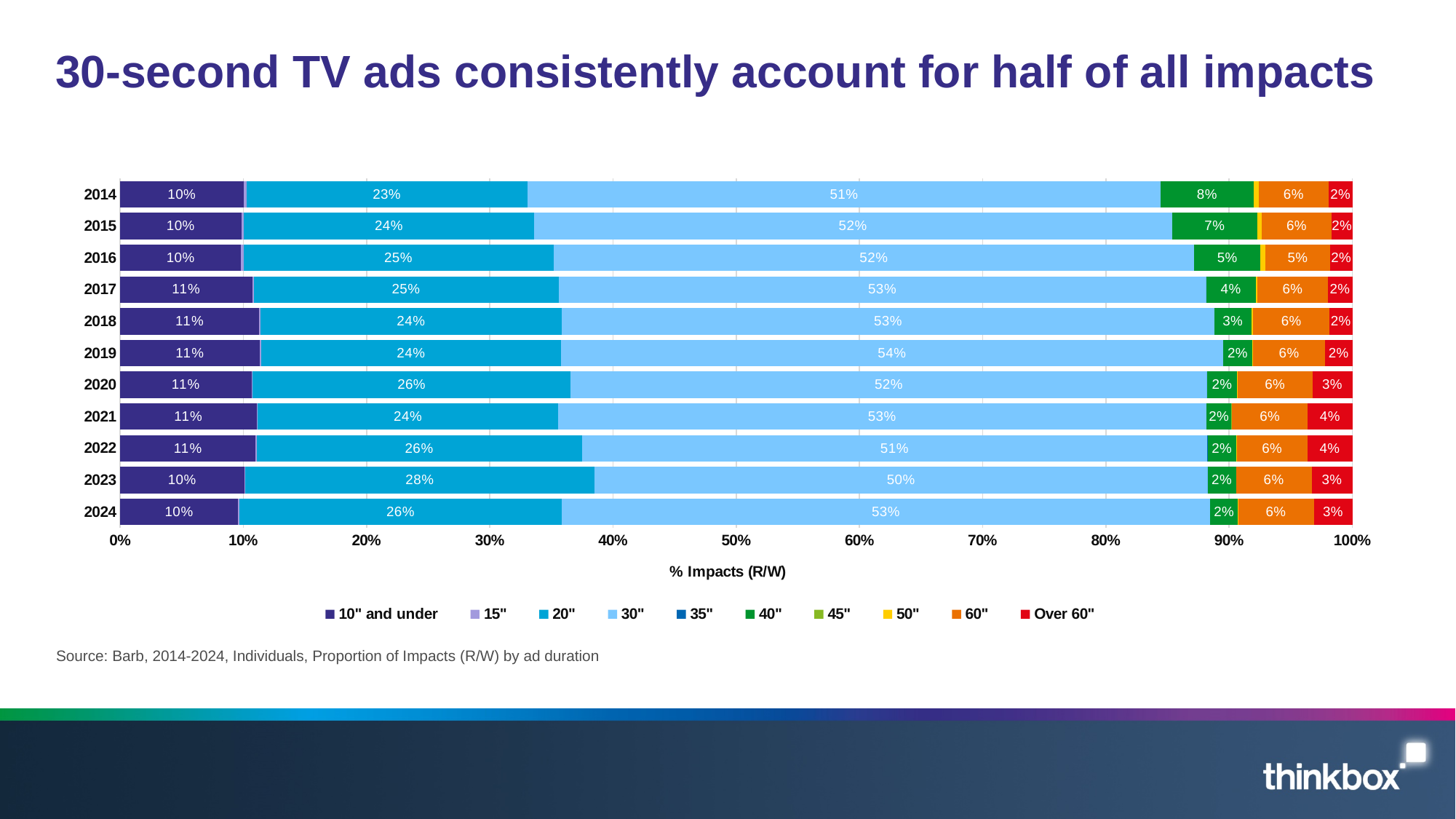
How many years are shown on the chart? 11 Which year had the larger 40" share of impacts, 2014 or 2024? 2014 By how many percentage points did the 20" share in 2023 exceed the 20" share in 2014? 5 percentage points Does the 40" share of impacts rise or fall from 2014 to 2024? Fall What type of chart is shown on the slide? Stacked bar chart In which year was the 30" share of impacts highest? 2019 In which year was the 30" share of impacts lowest? 2023 What share of impacts did 'Over 60"' ads have in 2021? 4% In which year was the 40" share of impacts highest? 2014 How many ad duration series does the legend list? 10 What is the value for 20" ads in 2023? 28% What percentage of impacts did 30" ads account for in 2014? 51%